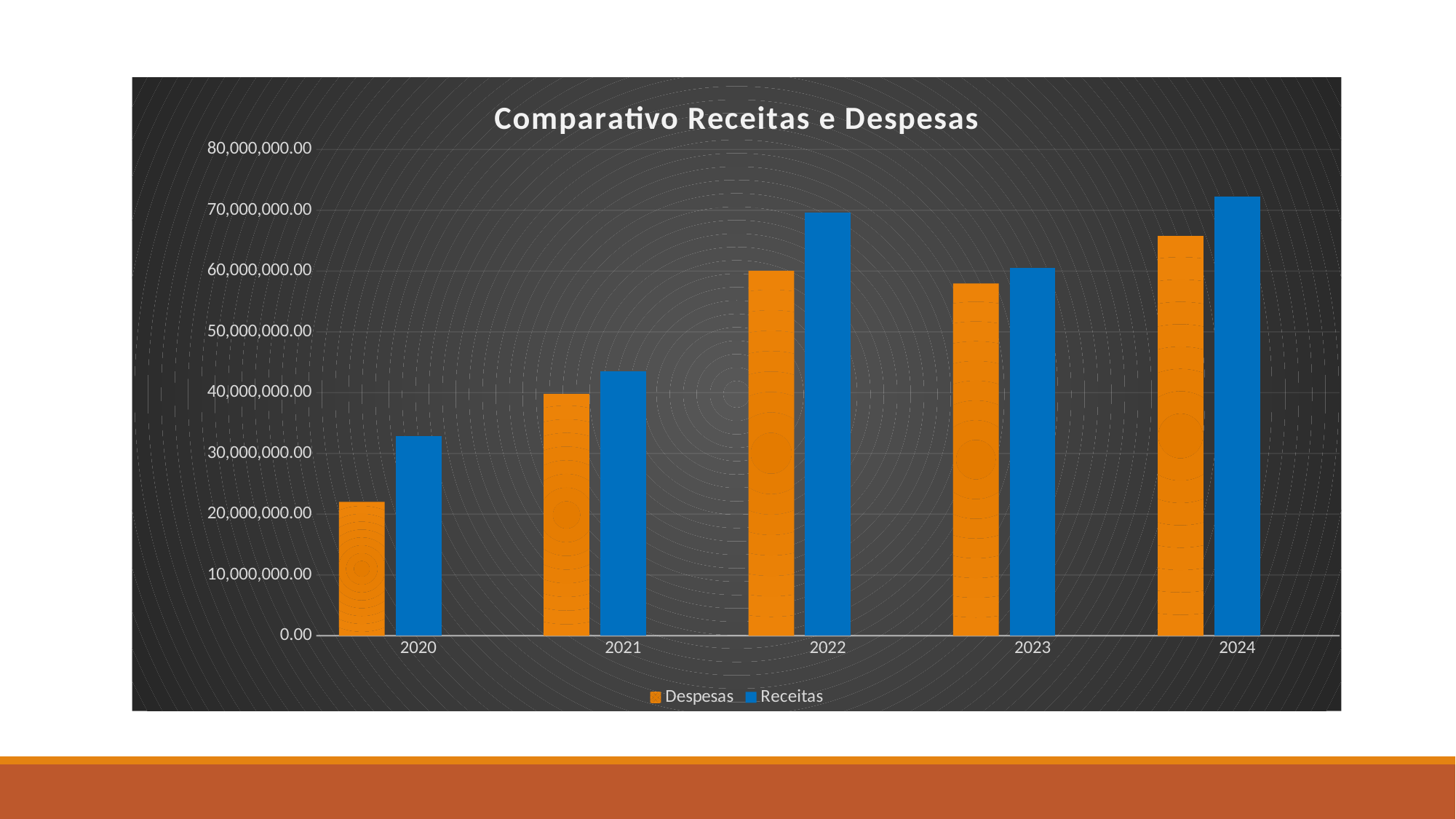
What is the title of the chart? Comparativo Receitas e Despesas Is the value for Despesas in 2023 greater or less than 50,000,000.00? greater How many years are shown on the x axis? 5 Is the value for Despesas in 2020 greater or less than 30,000,000.00? less Is the value for Receitas in 2024 greater or less than 70,000,000.00? greater Do the Despesas values rise or fall from 2020 to 2022? rise Which colour represents Receitas in the chart? blue In which year is Despesas lowest? 2020 How many series does the legend list? 2 In which year is Receitas highest? 2024 In 2022, which is larger, Despesas or Receitas? Receitas What kind of chart is shown on the slide? bar chart